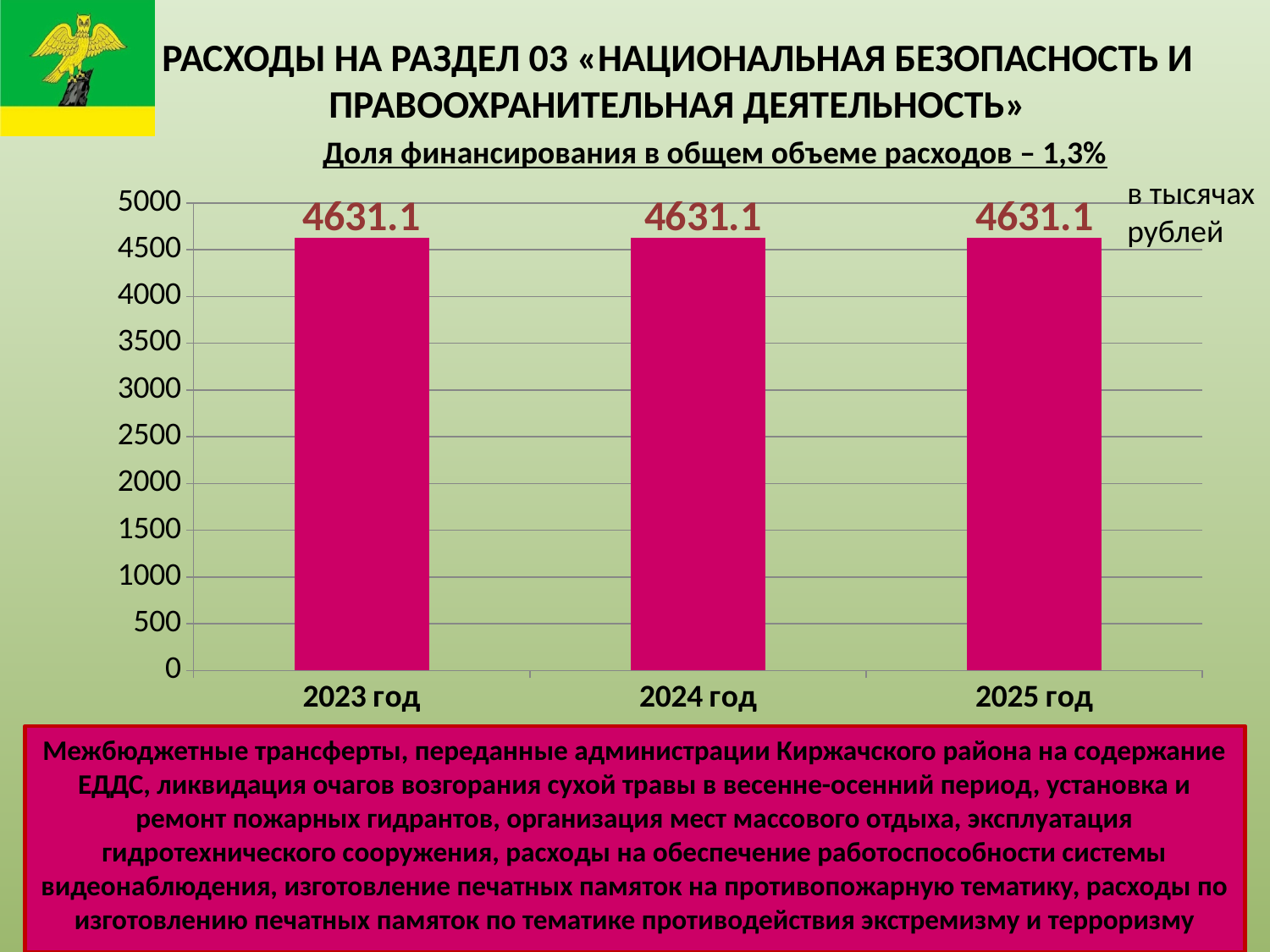
What is the value for 2025 год? 4631.1 What share of total expenditure does this section account for, according to the chart subtitle? 1,3% In what units are the chart values given, according to the note next to the chart? в тысячах рублей Is the value for 2025 год greater or less than 5000? less What is the value for 2024 год? 4631.1 How many categories (years) are shown on the x axis? 3 What is the value for 2023 год? 4631.1 What kind of chart is shown on the slide? bar chart Is the value for 2024 год greater or less than 4500? greater What is the difference between the values for 2023 год and 2025 год? 0 Do the values rise, fall or stay the same from 2023 год to 2025 год? stay the same